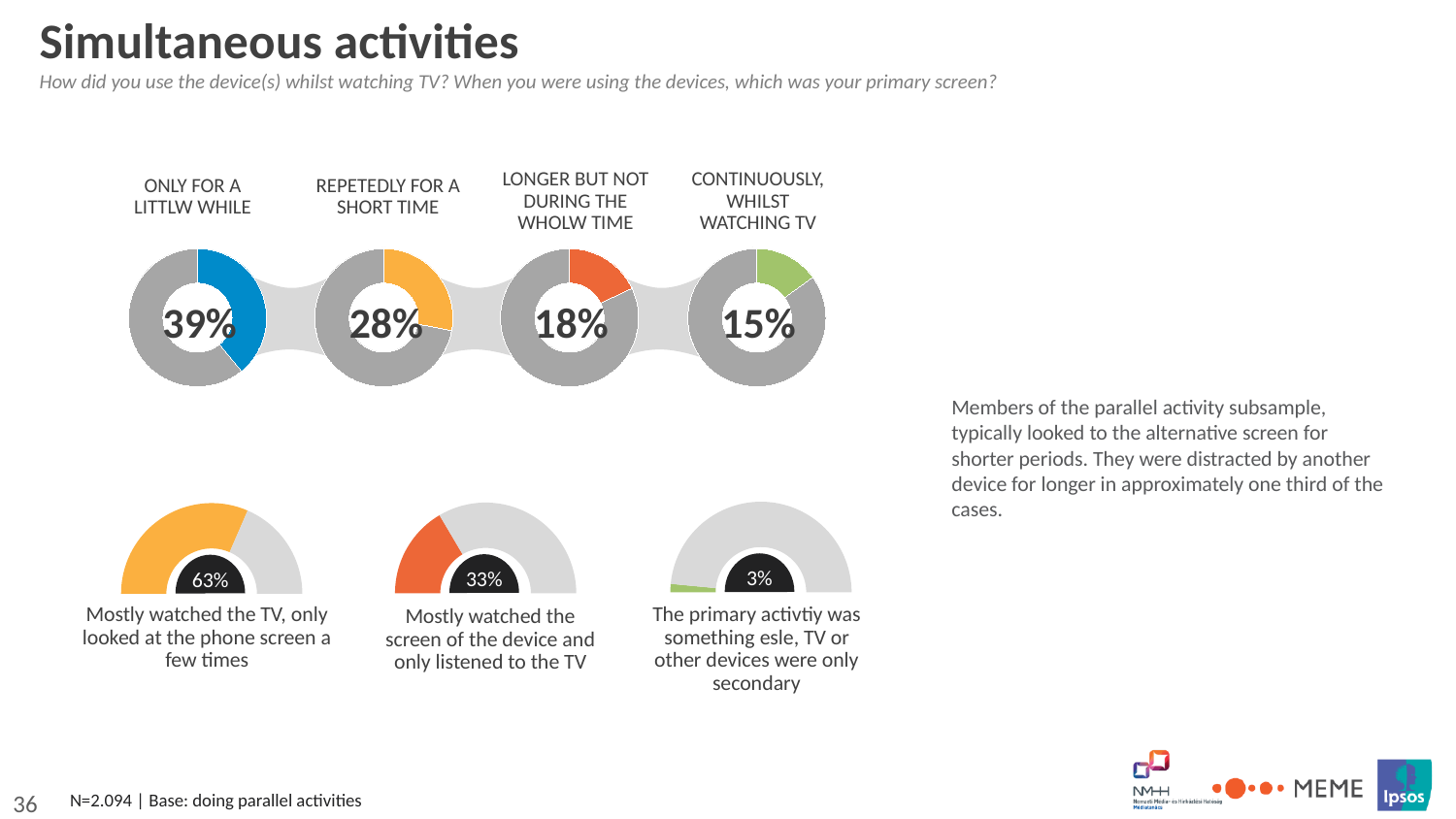
In the bottom row of half-donut gauges, which is larger: the value for mostly watching the TV or the value for mostly watching the device screen? Mostly watched the TV, only looked at the phone screen a few times In the top row of donut charts, what is the difference between the values for "ONLY FOR A LITTLW WHILE" and "LONGER BUT NOT DURING THE WHOLW TIME"? 21% In the top row of donut charts, what is the value shown for "CONTINUOUSLY, WHILST WATCHING TV"? 15% In the bottom row of half-donut gauges, what is the value for "Mostly watched the screen of the device and only listened to the TV"? 33% In the bottom row of half-donut gauges, what is the value for "Mostly watched the TV, only looked at the phone screen a few times"? 63% In the top row of donut charts, which category has the highest value? ONLY FOR A LITTLW WHILE In the top row of donut charts, what is the value shown for "ONLY FOR A LITTLW WHILE"? 39% In the bottom row of half-donut gauges, what is the value for "The primary activtiy was something esle, TV or other devices were only secondary"? 3% In the top row of donut charts, what is the value shown for "REPETEDLY FOR A SHORT TIME"? 28% What colour is the highlighted segment of the "ONLY FOR A LITTLW WHILE" donut chart in the top row? Blue How many donut charts are in the top row of the slide? 4 In the top row of donut charts, which category has the lowest value? CONTINUOUSLY, WHILST WATCHING TV